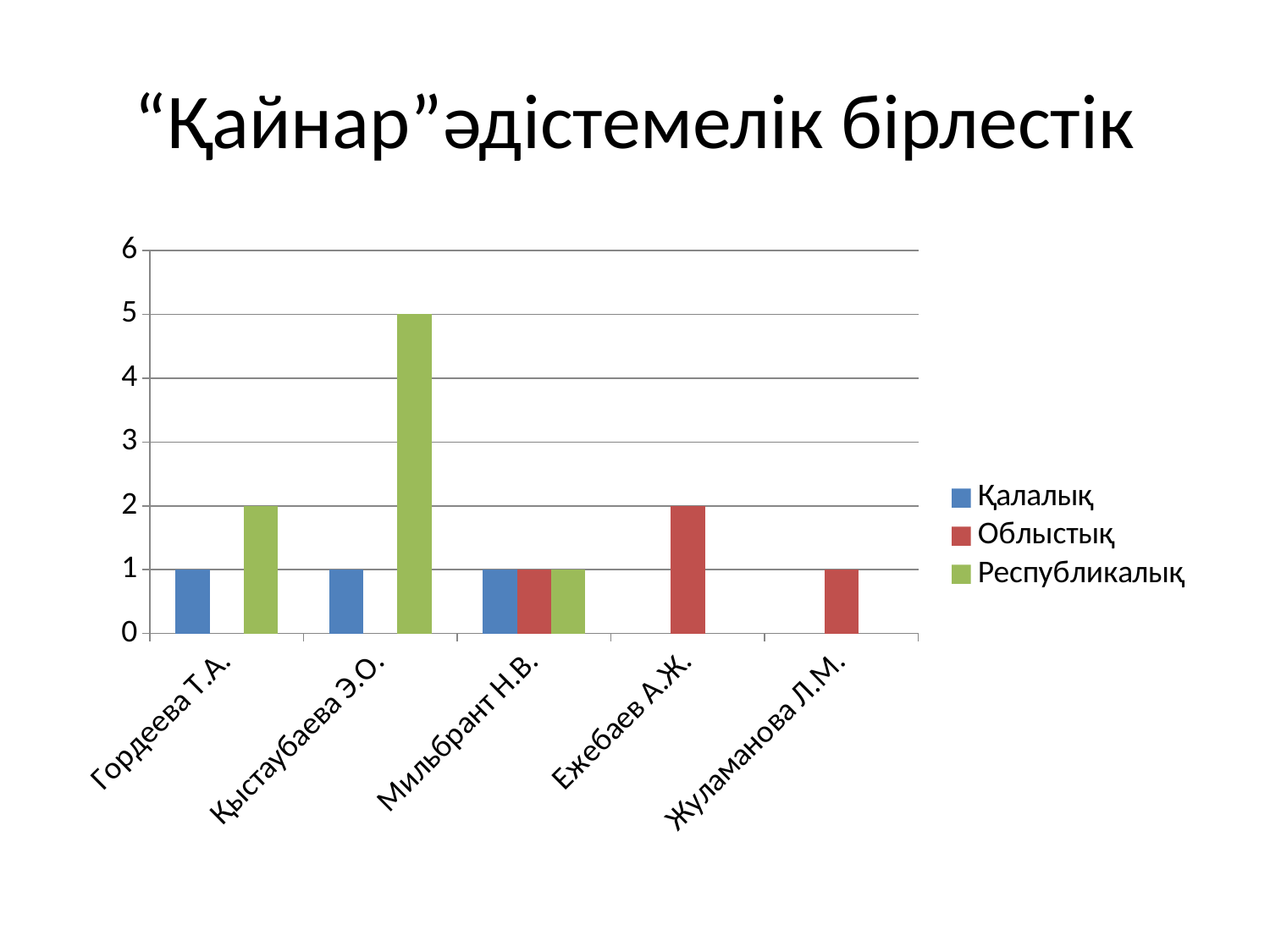
What is the Республикалық value for Гордеева Т.А.? 2 What is the Облыстық value for Жуламанова Л.М.? 1 Which is larger: the Облыстық value for Ежебаев А.Ж. or the Облыстық value for Жуламанова Л.М.? Ежебаев А.Ж. Which category has the highest Облыстық value? Ежебаев А.Ж. What is the title of the slide? “Қайнар”әдістемелік бірлестік How many categories (people) are shown on the x axis? 5 How many series does the legend list? 3 What is the difference between the Республикалық values for Қыстаубаева Э.О. and Гордеева Т.А.? 3 What is the Республикалық value for Қыстаубаева Э.О.? 5 What is the Облыстық value for Ежебаев А.Ж.? 2 What kind of chart is shown on the slide? bar chart Which category has the highest Республикалық value? Қыстаубаева Э.О.